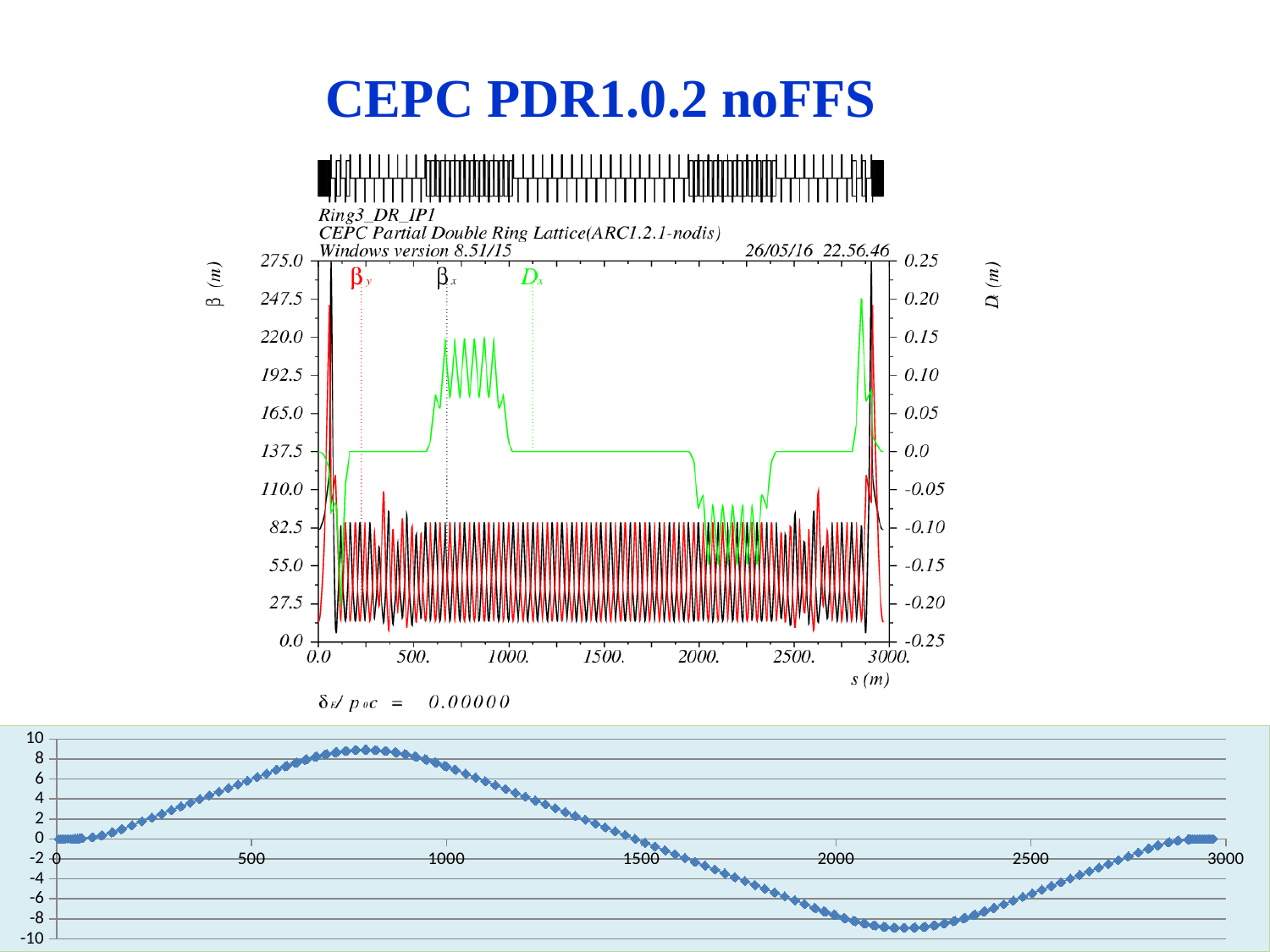
What kind of chart is the bottom chart on the slide? line chart In the bottom chart, is the value at x = 2500 greater or less than -4? less In the bottom chart, do the values rise or fall as x goes from 1000 to 2000? fall In the top chart, what is the highest tick value on the left vertical axis (β)? 275.0 In the bottom chart, is the lowest value of the curve (near x = 2100) greater or less than -8? less What is the maximum value shown on the vertical axis of the bottom chart? 10 In the bottom chart, which is larger: the value at x = 500 or the value at x = 2000? the value at x = 500 In the bottom chart, is the peak value of the curve (near x = 800) greater or less than 8? greater In the top chart, how many curves (series) are labelled in the plot? 3 In the bottom chart, do the values rise or fall as x goes from 0 to 800? rise In the top chart, what is the label of the horizontal axis? s (m)